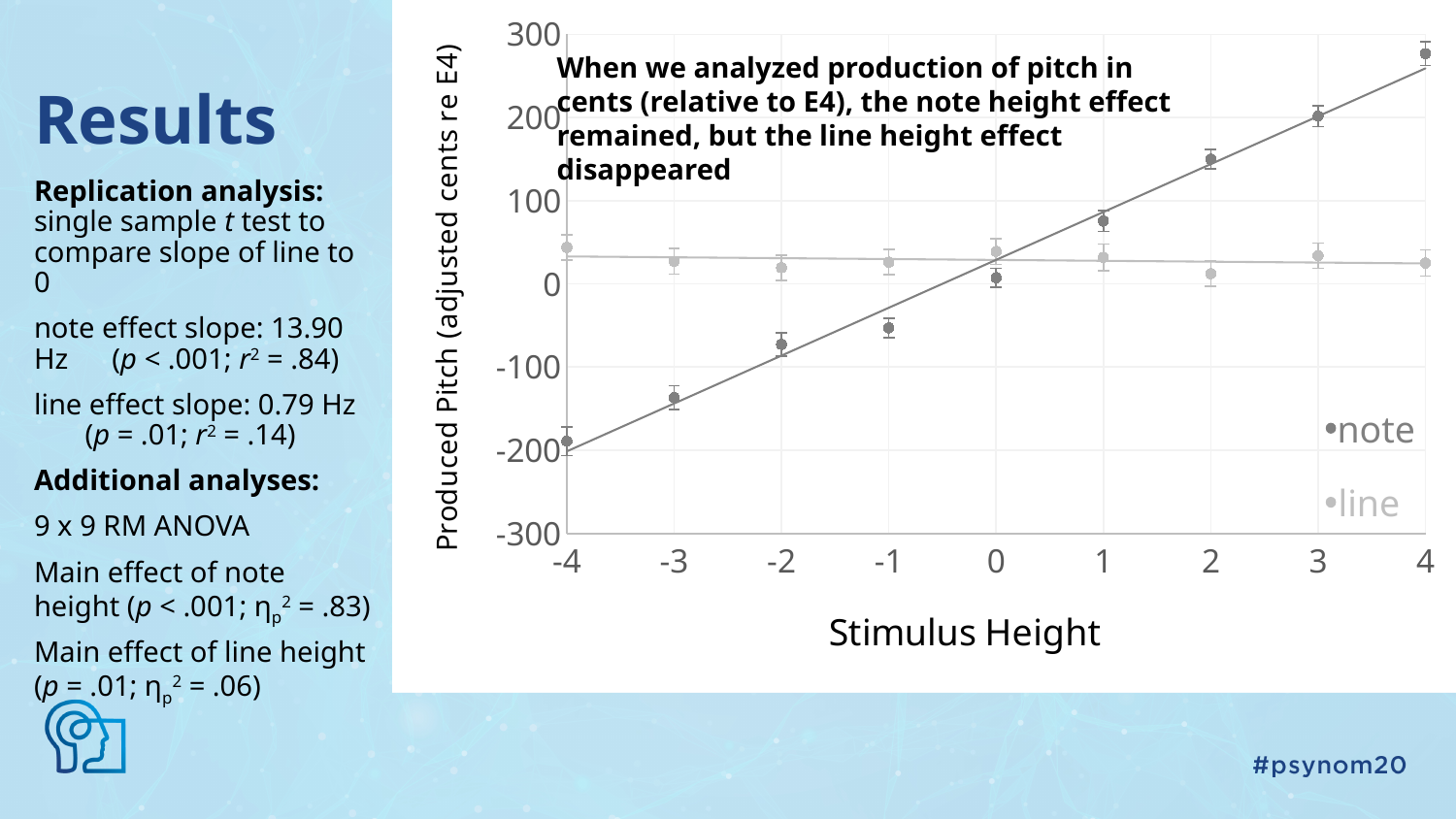
Do the values of the note series rise or fall as Stimulus Height increases from -4 to 4? rise At Stimulus Height -4, which series has the larger value, note or line? line How many data points are plotted for the note series? 9 Is the value for the note series at Stimulus Height -4 greater or less than -100? less Is the value for the note series at Stimulus Height 4 greater or less than 200? greater At Stimulus Height 4, which series has the larger value, note or line? note At which Stimulus Height does the note series reach its highest value? 4 What kind of chart is shown on the slide? scatter plot Is the value for the note series at Stimulus Height 2 greater or less than 100? greater What is the title of the x axis? Stimulus Height How many series does the legend list? 2